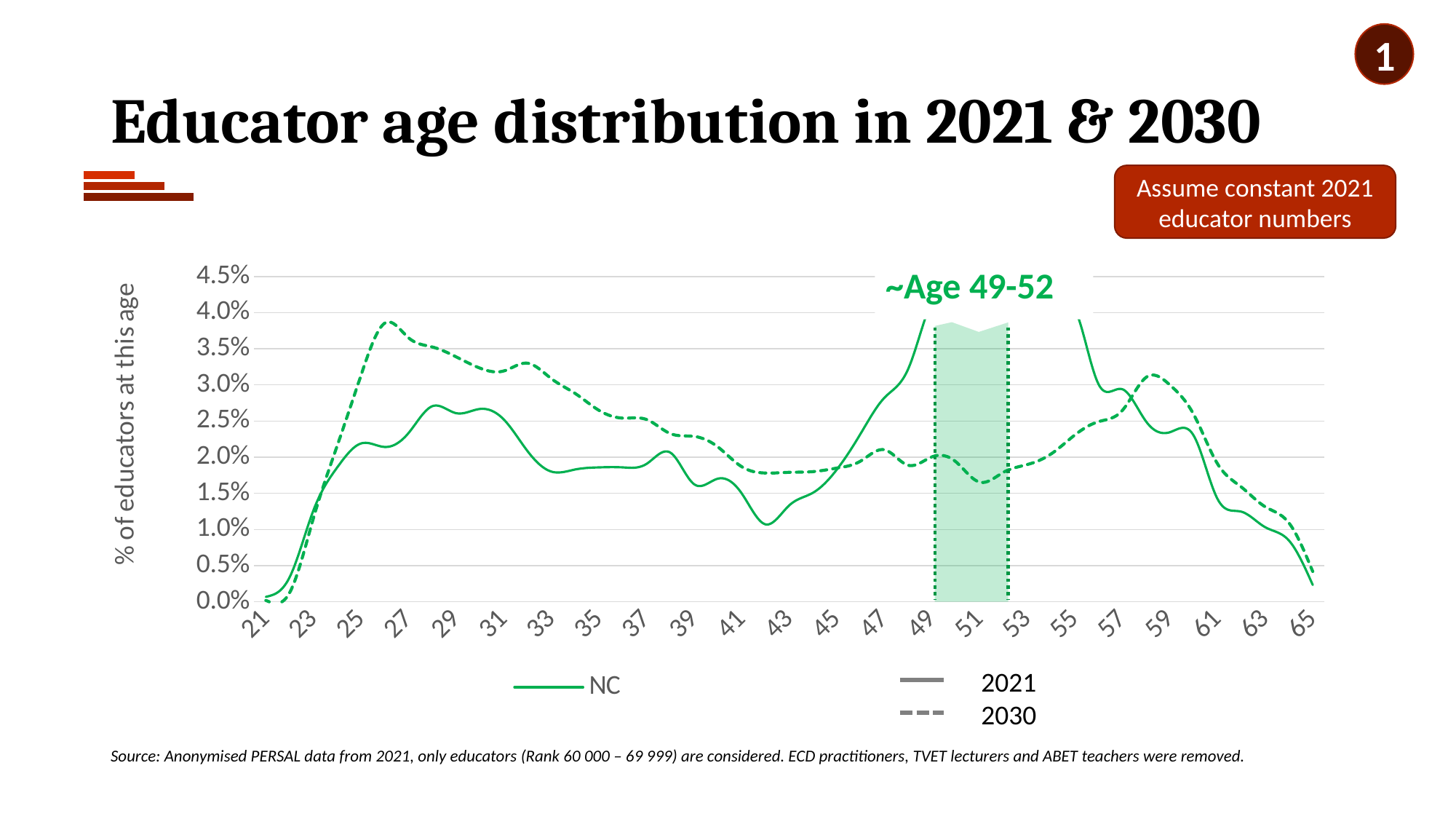
Is the 2021 value at age 26 greater or less than 2.5%? less How many years (series) does the legend distinguish by line style? 2 Is the 2030 value at age 26 greater or less than 3.5%? greater At age 51, which series has the higher value, 2021 or 2030? 2021 What kind of chart is shown on the slide? line chart Which line style represents 2030 in the chart? dashed Does the 2021 line rise or fall between age 59 and age 65? fall Does the 2030 line rise or fall between age 21 and age 26? rise Is the 2021 value at age 42 greater or less than 1.5%? less What age range is highlighted with the shaded band on the chart? ~Age 49-52 At age 26, which series has the higher value, 2021 or 2030? 2030